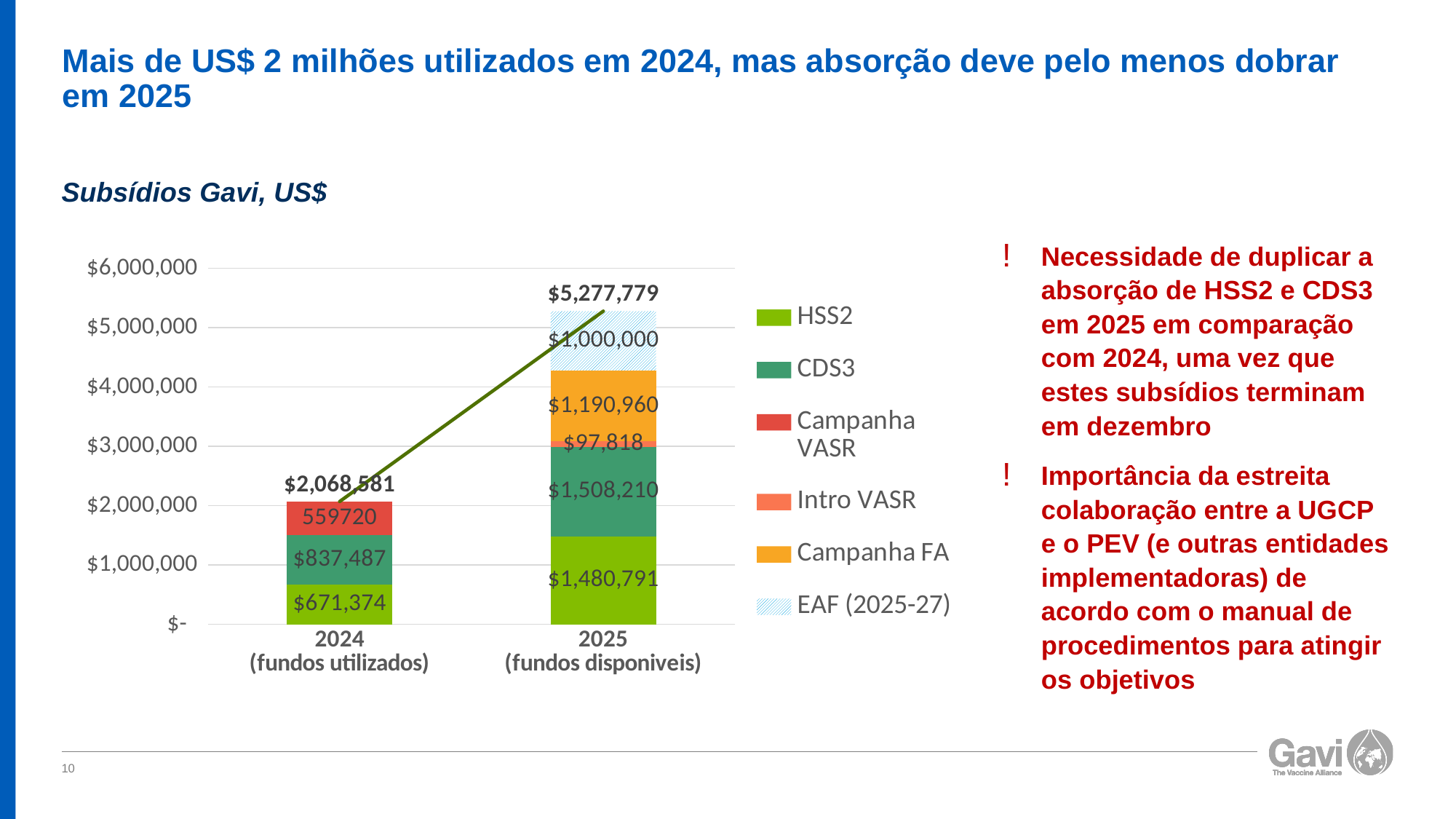
How much larger is the HSS2 value in 2025 than in 2024? $809,417 What is the value of Intro VASR for 2025 (fundos disponiveis)? $97,818 What kind of chart is shown on the slide? Stacked bar chart What is the value of CDS3 for 2025 (fundos disponiveis)? $1,508,210 Which is larger in 2025: the CDS3 value or the Campanha FA value? CDS3 What is the value of HSS2 for 2024 (fundos utilizados)? $671,374 What is the total of the stacked bar for 2025 (fundos disponiveis)? $5,277,779 What is the total of the stacked bar for 2024 (fundos utilizados)? $2,068,581 How many series does the legend list? 6 How many categories are shown on the x axis? 2 Which series appears only in the 2025 bar with a hatched pattern? EAF (2025-27) What is the value of Campanha FA for 2025 (fundos disponiveis)? $1,190,960